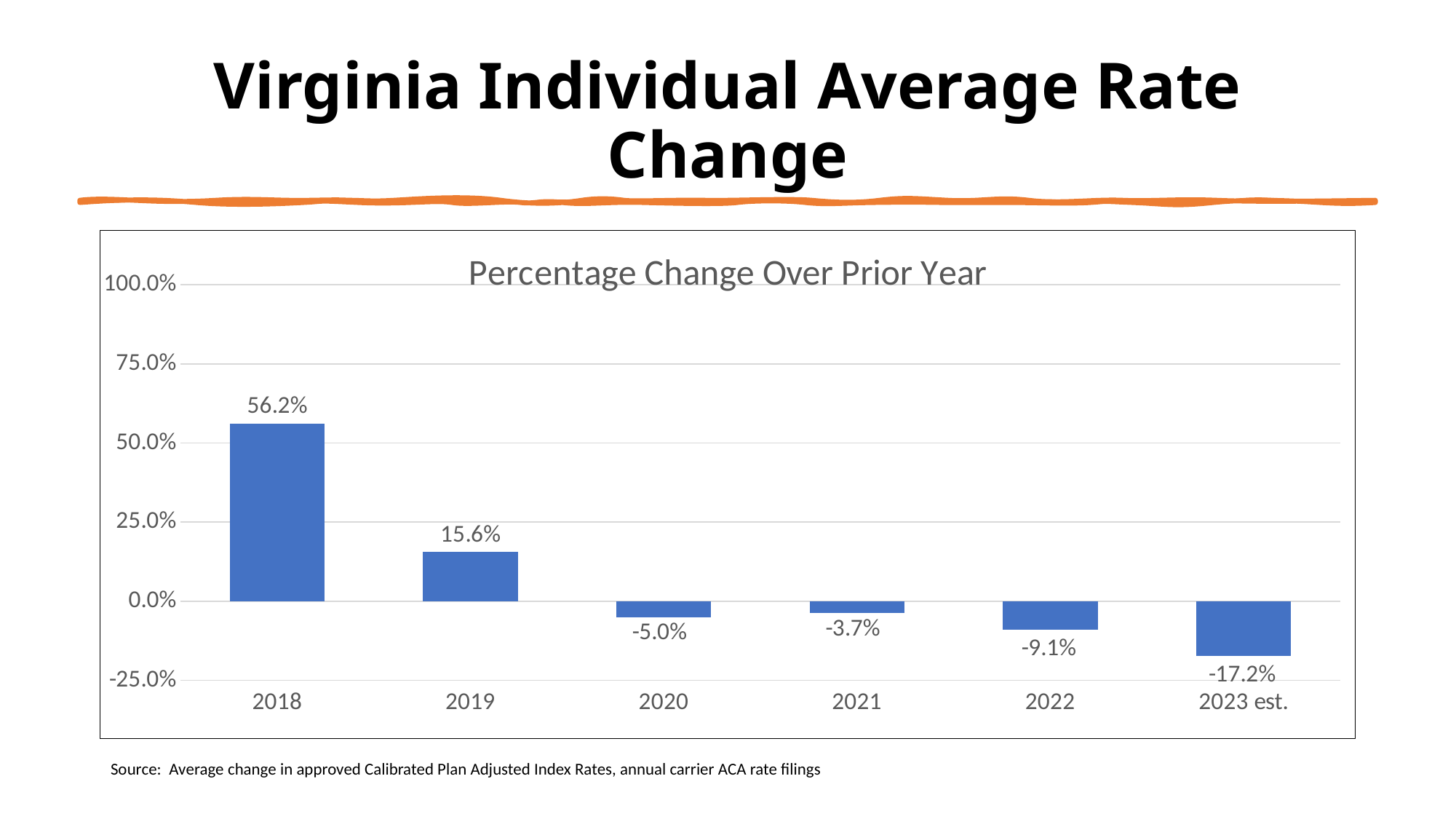
What is the percentage change for 2023 est.? -17.2% What is the percentage change for 2019? 15.6% What is the percentage change for 2020? -5.0% Which year has the lowest percentage change? 2023 est. Which year has a larger percentage change, 2021 or 2022? 2021 What is the difference between the percentage change in 2018 and in 2019? 40.6 percentage points What is the percentage change for 2022? -9.1% What is the percentage change for 2018? 56.2% How many years are shown on the x axis? 6 Which year has the highest percentage change? 2018 What is the title of the chart? Percentage Change Over Prior Year What kind of chart is shown on the slide? Bar chart